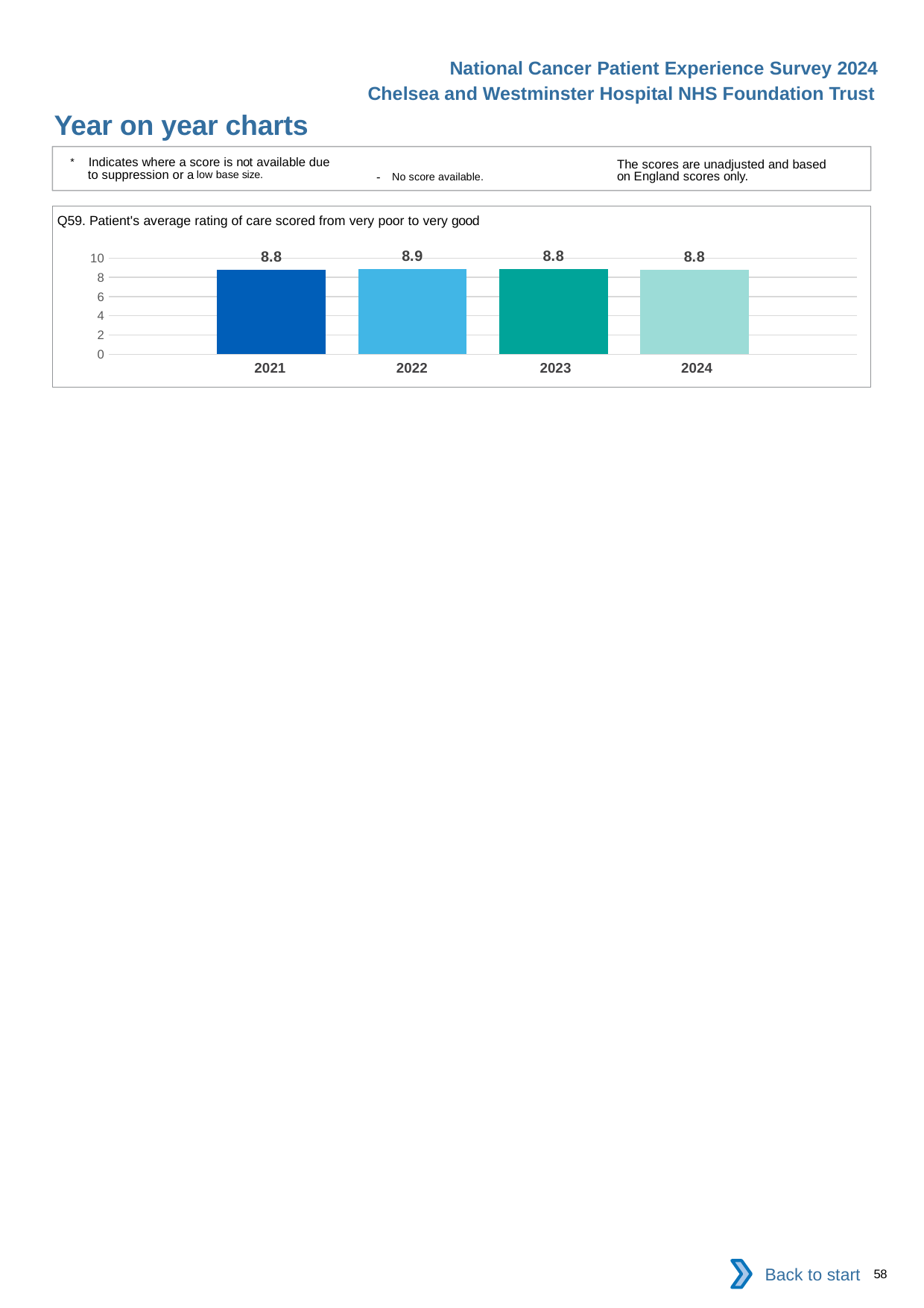
Is the value for 2022 larger than the value for 2021? Yes What is the value for 2021? 8.8 Is the value for 2023 greater or less than 10? less Which year has the highest value? 2022 What kind of chart is shown? Bar chart What is the difference between the values for 2022 and 2023? 0.1 What is the title of the chart? Q59. Patient's average rating of care scored from very poor to very good What is the value for 2024? 8.8 How many years are shown on the chart? 4 What is the maximum value shown on the vertical axis? 10 What is the value for 2022? 8.9